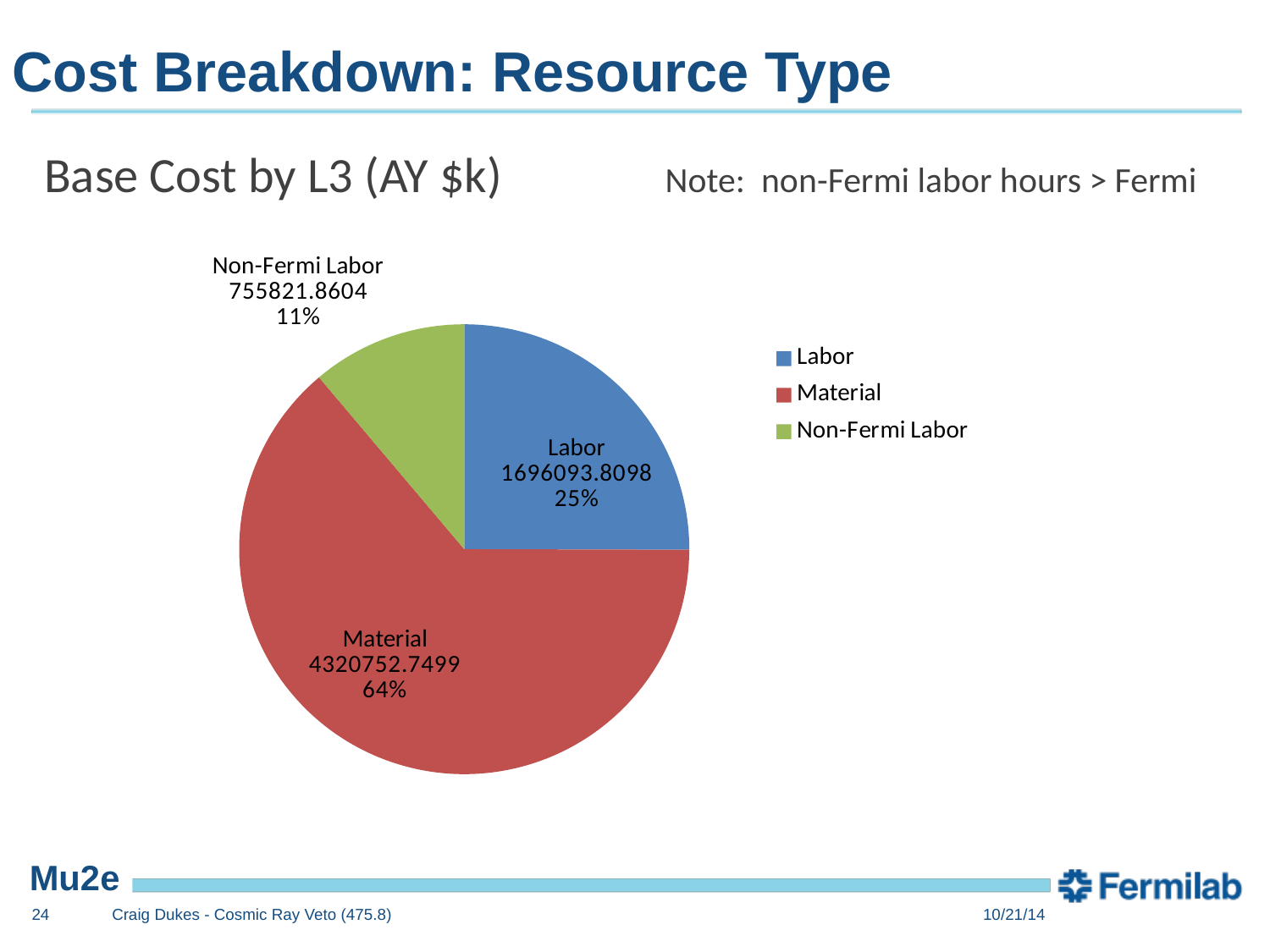
What is the value for Labor? 1696093.8098 Which is larger, the value for Labor or the value for Non-Fermi Labor? Labor Which category has the largest share of the pie? Material What kind of chart is shown on the slide? pie chart What percentage share of the pie does Labor have? 25% How many categories does the pie chart have? 3 What is the value for Non-Fermi Labor? 755821.8604 What is the value for Material? 4320752.7499 What is the title of the chart? Base Cost by L3 (AY $k) Which category has the smallest share of the pie? Non-Fermi Labor Which colour represents Material in the pie chart? red What percentage share of the pie does Non-Fermi Labor have? 11%